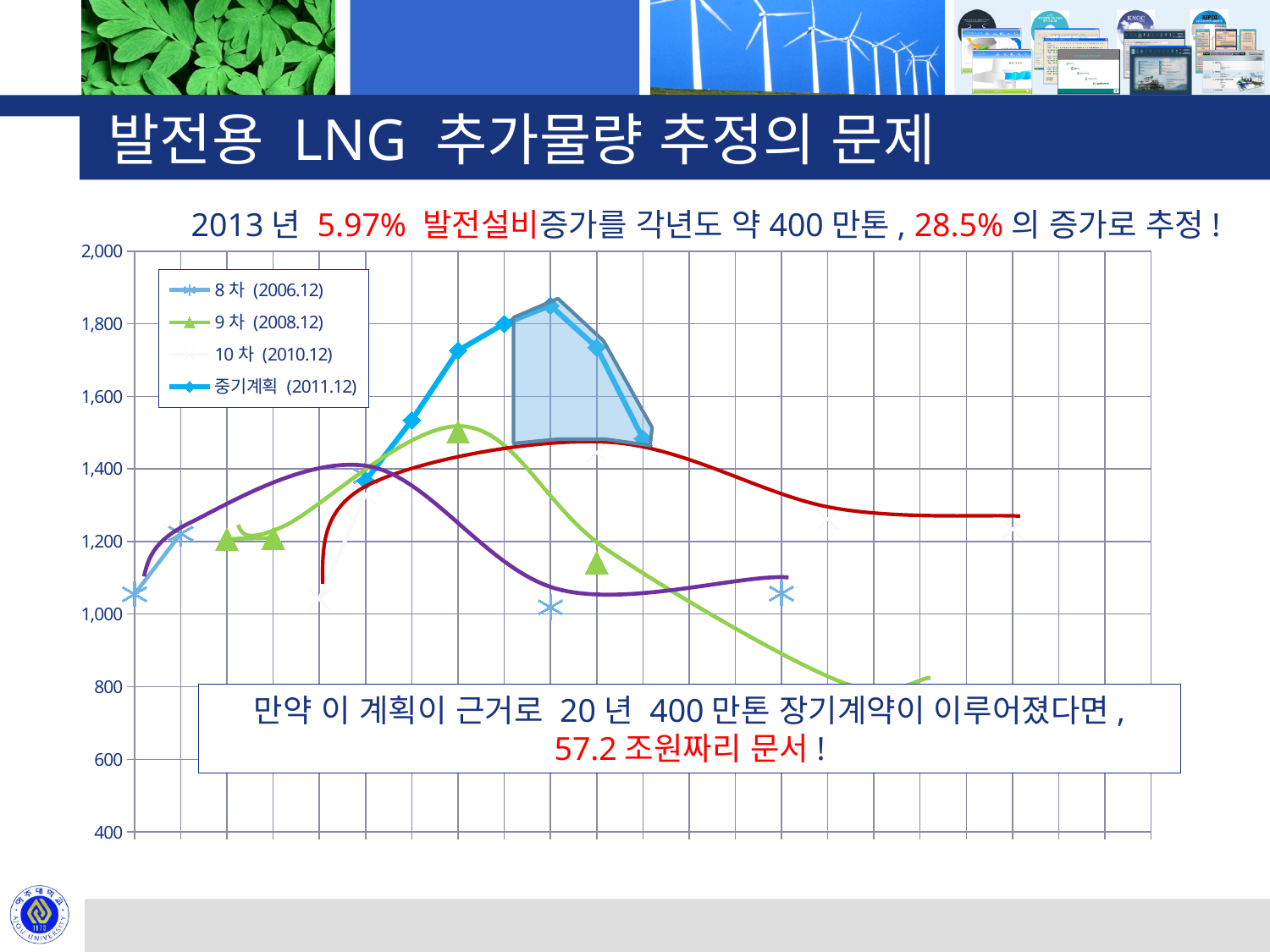
How many series does the chart legend list? 4 Is the last point of the 중기계획 (2011.12) series greater or less than 1,400? greater Is the peak value of the 9 차 (2008.12) series greater or less than 1,400? greater What is the highest value shown on the y axis? 2,000 What kind of chart is shown on the slide? line chart Which legend entry is dated 2010.12? 10 차 (2010.12) Is the first point of the 8 차 (2006.12) series greater or less than 1,000? greater Which series reaches the highest value on the chart? 중기계획 (2011.12) Does the 중기계획 (2011.12) series rise or fall from its first point to its peak? rise Which series drops to the lowest value on the chart? 9 차 (2008.12)